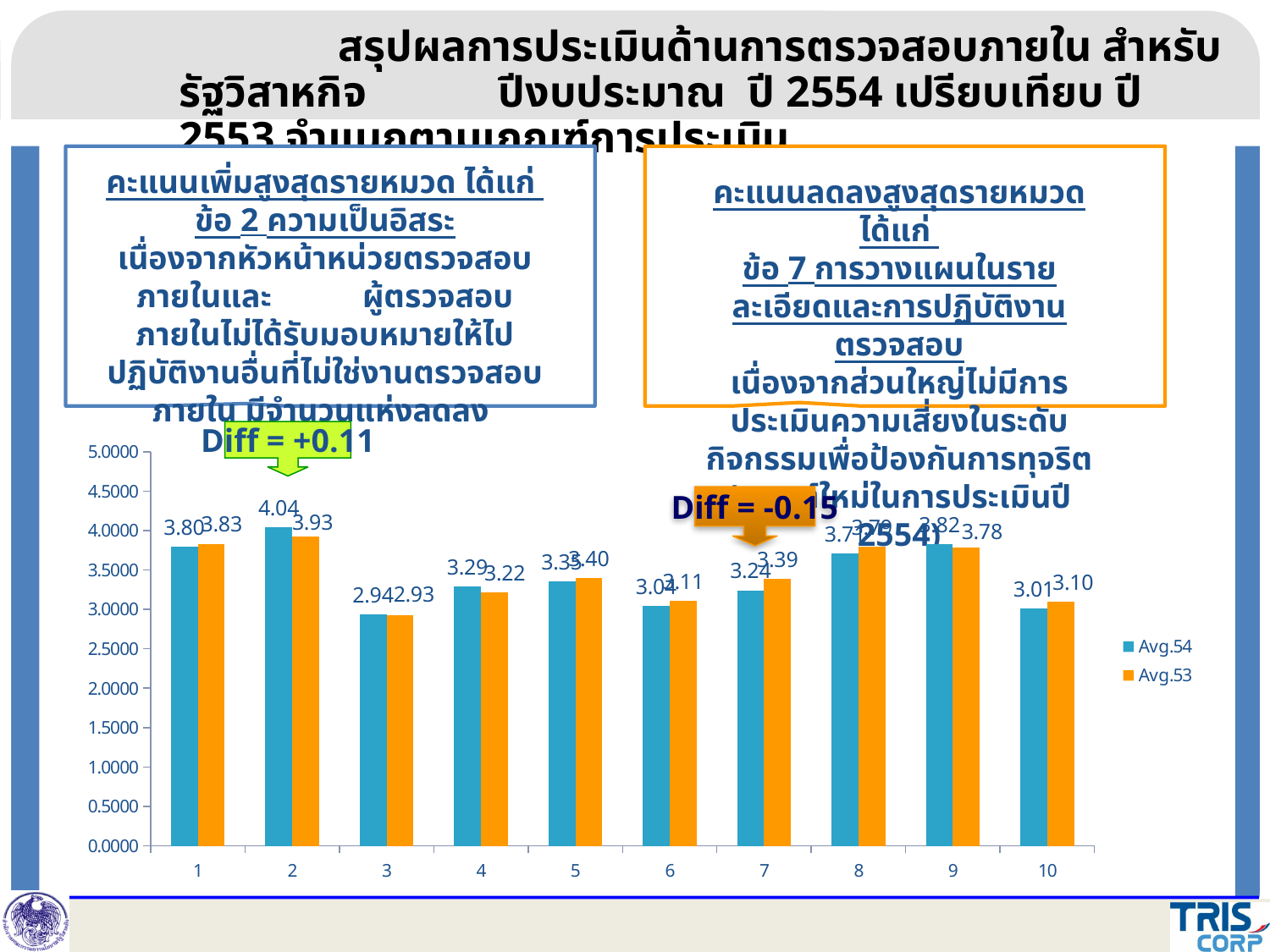
For category 2, how much higher is Avg.54 than Avg.53? 0.11 What is the Avg.54 value for category 10? 3.01 How many categories are shown on the x axis? 10 Which category has the lowest Avg.53 value? 3 Is the Avg.54 value for category 3 greater or less than 3.0000? less How many series does the legend list? 2 What is the Avg.54 value for category 2? 4.04 What kind of chart is shown on the slide? bar chart Which category has the highest Avg.54 value? 2 For category 7, how much lower is Avg.54 than Avg.53? 0.15 For category 5, which series has the larger value, Avg.54 or Avg.53? Avg.53 What is the Avg.53 value for category 7? 3.39